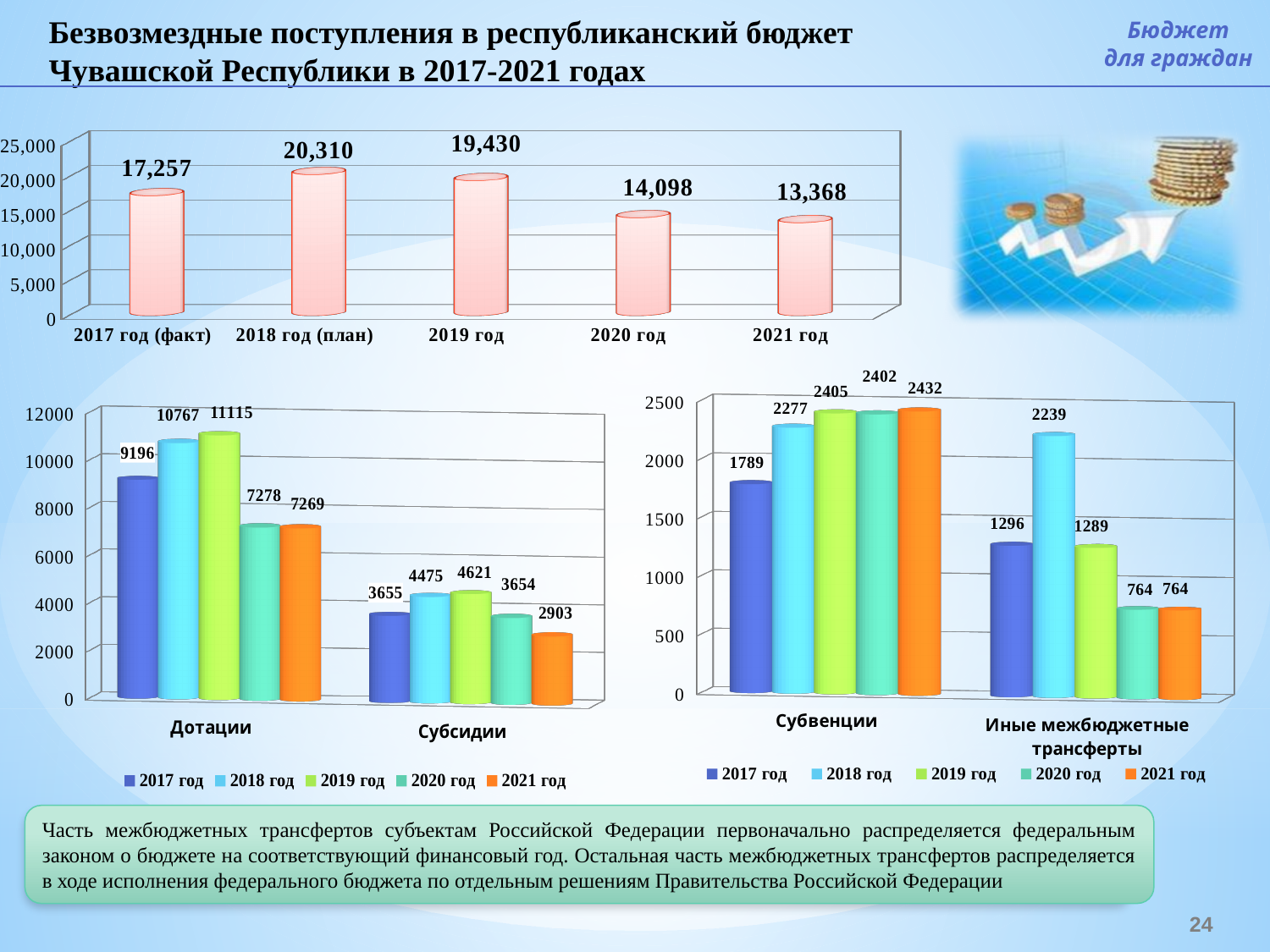
In the top chart, what is the difference between the values for 2019 год and 2020 год? 5,332 In the bottom-left chart, what is the value for Субсидии in 2021 год? 2903 In the bottom-left chart, what is the value for Дотации in 2019 год? 11115 In the top chart, which year has the lowest value? 2021 год How many bars are in the top chart? 5 In the bottom-right chart, what is the difference between Субвенции in 2018 год and 2017 год? 488 How many series does the legend of the bottom-left chart list? 5 In the top chart, which year has the highest value? 2018 год (план) In the bottom-left chart, which is larger for Субсидии: 2018 год or 2020 год? 2018 год In the top chart, what is the value for 2018 год (план)? 20,310 What kind of chart is the bottom-right chart? bar chart In the bottom-right chart, what is the value for Иные межбюджетные трансферты in 2018 год? 2239